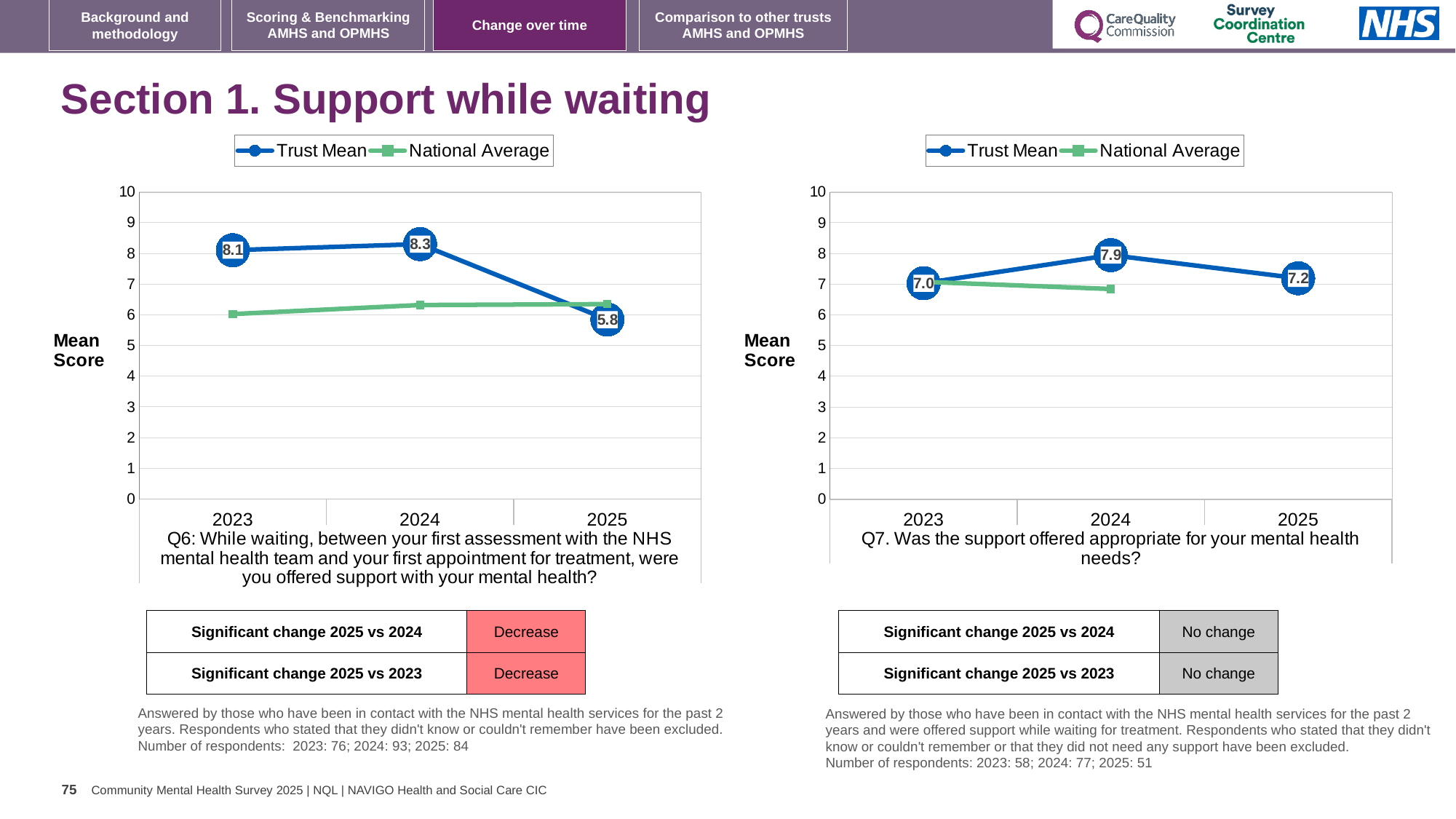
In the Q7 chart on the right, is the Trust Mean for 2024 larger or smaller than the Trust Mean for 2025? larger How many years are shown on the x axis of the Q6 chart on the left? 3 In the Q7 chart on the right, what is the difference between the Trust Mean in 2024 and in 2023? 0.9 In the Q7 chart on the right, what is the Trust Mean for 2024? 7.9 How many series does the legend of the Q6 chart on the left list? 2 In the Q6 chart on the left, what is the Trust Mean for 2023? 8.1 In the Q6 chart on the left, what is the Trust Mean for 2025? 5.8 In the Q6 chart on the left, is the National Average for 2023 greater or less than 7? less In the Q7 chart on the right, which year has the lowest Trust Mean? 2023 In the Q6 chart on the left, which year has the highest Trust Mean? 2024 What type of chart is the Q7 chart on the right? Line chart In the Q6 chart on the left, what is the difference between the Trust Mean in 2024 and in 2025? 2.5